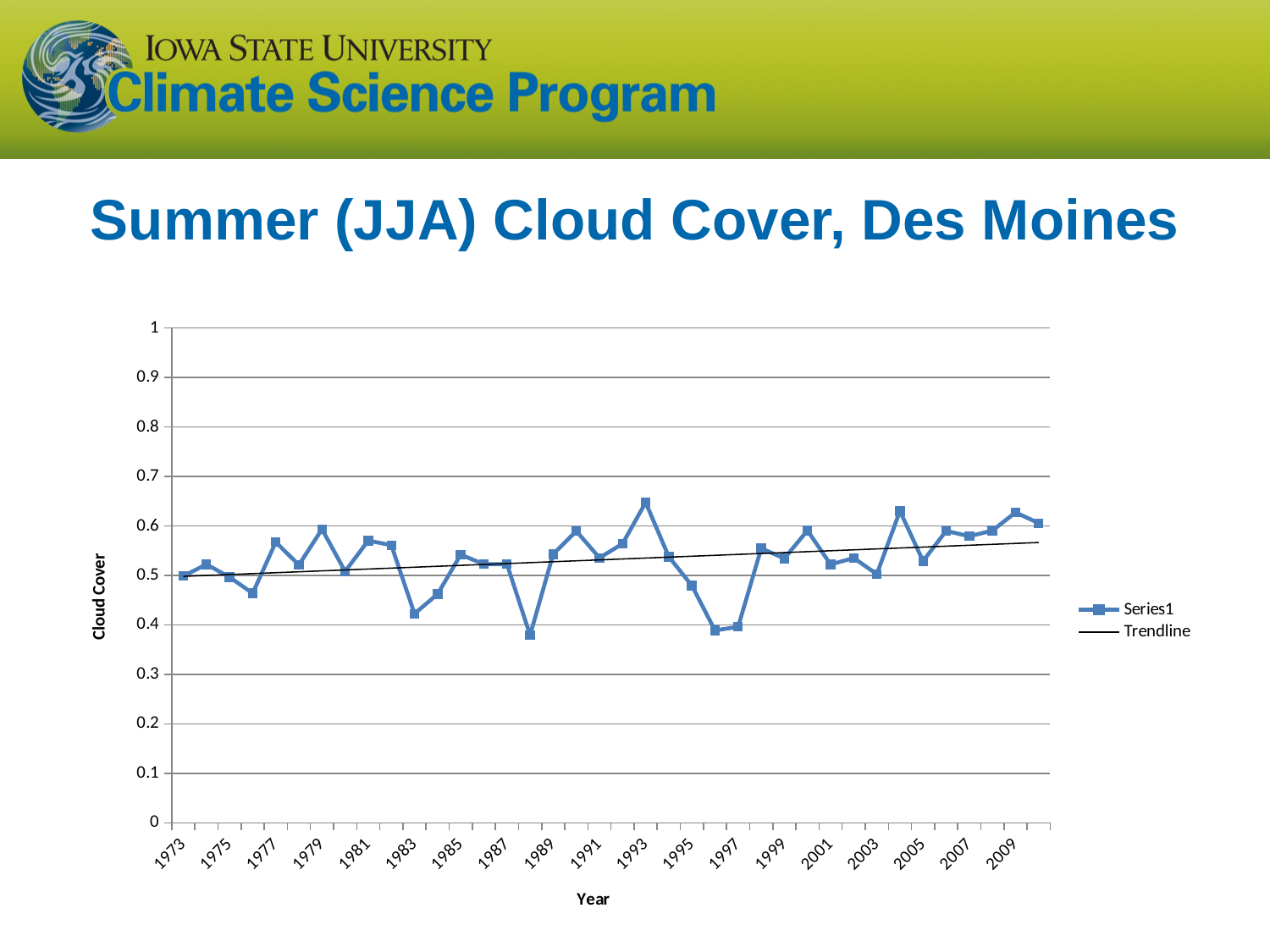
Is the Series1 value for 1988 greater or less than 0.4? less Does the trendline rise or fall from 1973 to 2010? rises Is the Series1 value for 1993 greater or less than 0.6? greater What kind of chart is shown on the slide? line chart Is the Series1 value for 2004 greater or less than 0.6? greater Which year has the larger Series1 value, 1996 or 2000? 2000 How many series does the legend list? 2 In which year does Series1 reach its lowest cloud cover value? 1988 What are the two entries listed in the legend? Series1 and Trendline In which year does Series1 reach its highest cloud cover value? 1993 What is the title of the vertical axis? Cloud Cover